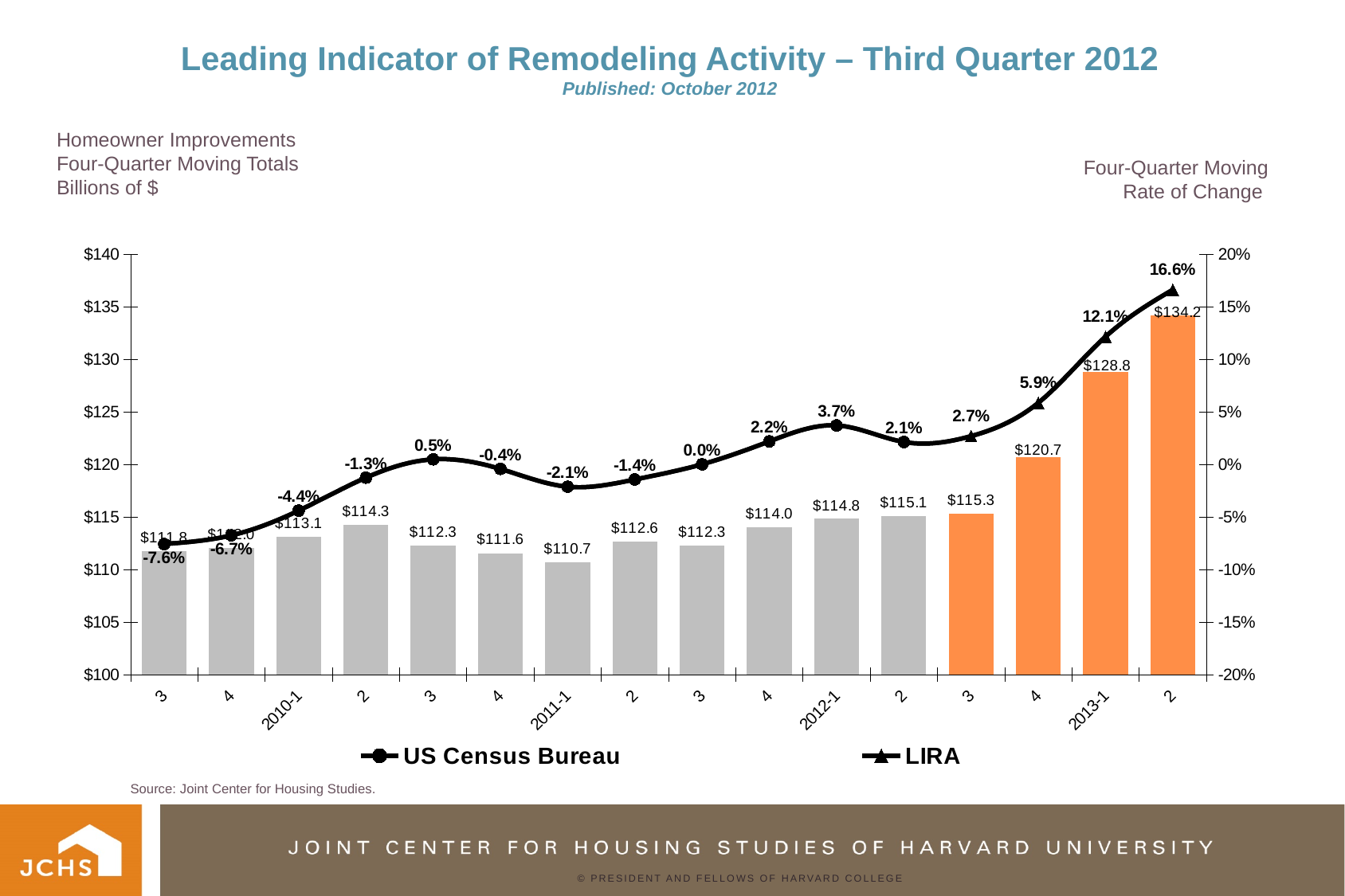
What is the four-quarter moving rate of change shown for 2011-1? -2.1% What is the four-quarter moving total for homeowner improvements in 2013-1? $128.8 How many series does the legend list? 2 How many quarterly bars are plotted on the chart? 16 Is the four-quarter moving rate of change for 2013-1 greater or less than 10%? greater Which is larger, the four-quarter moving total for 2011-1 or for 2012-1? 2012-1 Do the four-quarter moving total bars rise or fall from 2012 quarter 3 to 2013 quarter 2? rise What is the difference between the four-quarter moving totals for 2013 quarter 2 and 2013-1? $5.4 Which quarter has the highest four-quarter moving total bar? 2013 quarter 2 ($134.2) Which quarter has the lowest four-quarter moving total bar? 2011-1 ($110.7) What is the four-quarter moving rate of change shown for 2012-1? 3.7% What is the lowest four-quarter moving rate of change shown on the line? -7.6%